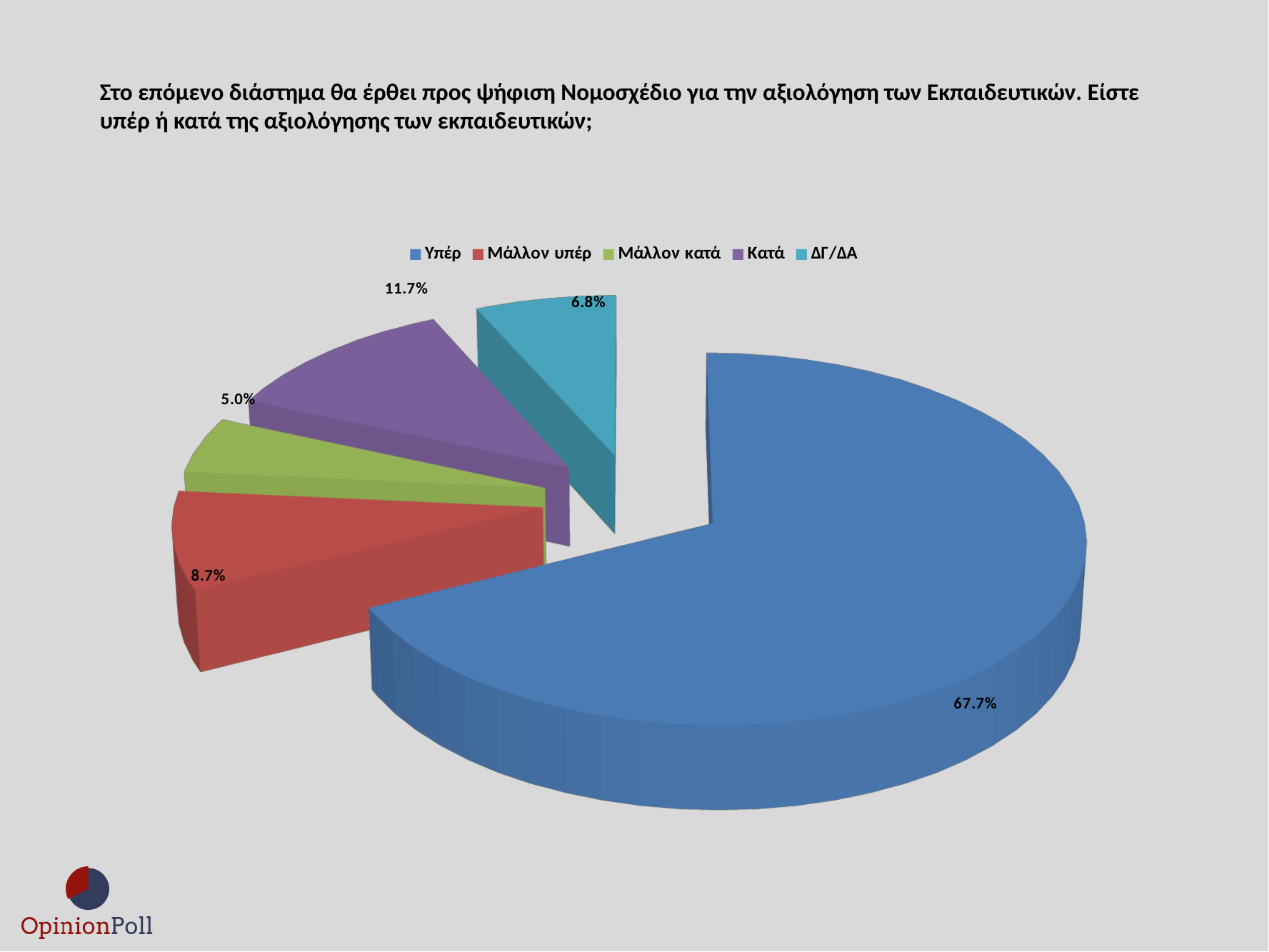
Which colour represents Κατά in the legend? Purple How many slices does the pie chart have? 5 What percentage is shown for Υπέρ? 67.7% What percentage is shown for Μάλλον κατά? 5.0% What kind of chart is shown on the slide? Pie chart Which is larger, the share for Μάλλον υπέρ or the share for ΔΓ/ΔΑ? Μάλλον υπέρ What percentage is shown for ΔΓ/ΔΑ? 6.8% What percentage is shown for Μάλλον υπέρ? 8.7% What percentage is shown for Κατά? 11.7% What is the difference in percentage points between Κατά and Μάλλον υπέρ? 3.0 Which category has the largest share of the pie? Υπέρ Which category has the smallest share of the pie? Μάλλον κατά